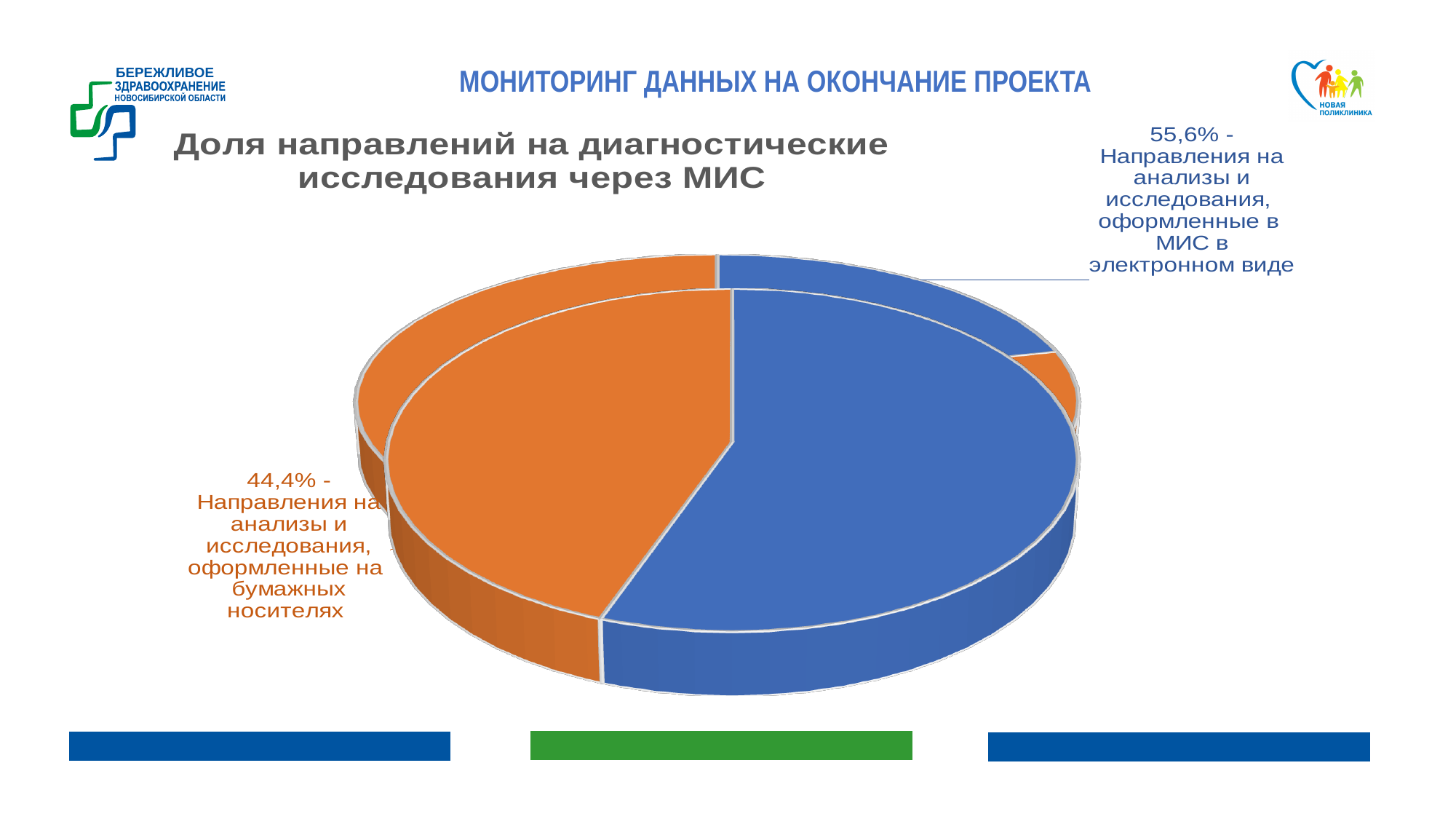
What do the two slices of the pie add up to? 100% Which slice of the pie is the smallest? Направления на анализы и исследования, оформленные на бумажных носителях (44,4%) What share of referrals for tests and examinations were issued in the MIS in electronic form? 55,6% What colour is the slice representing referrals issued on paper? Orange What is the title of the chart? Доля направлений на диагностические исследования через МИС How many slices does the pie chart have? 2 What kind of chart is shown on the slide? Pie chart Which is larger: the share of referrals issued electronically in the MIS or the share issued on paper? Electronically in the MIS Which slice of the pie is the largest? Направления на анализы и исследования, оформленные в МИС в электронном виде (55,6%) Is the share of referrals issued on paper greater or less than 50%? less By how many percentage points does the share of electronic referrals exceed the share of paper referrals? 11,2% What share of referrals for tests and examinations were issued on paper? 44,4%